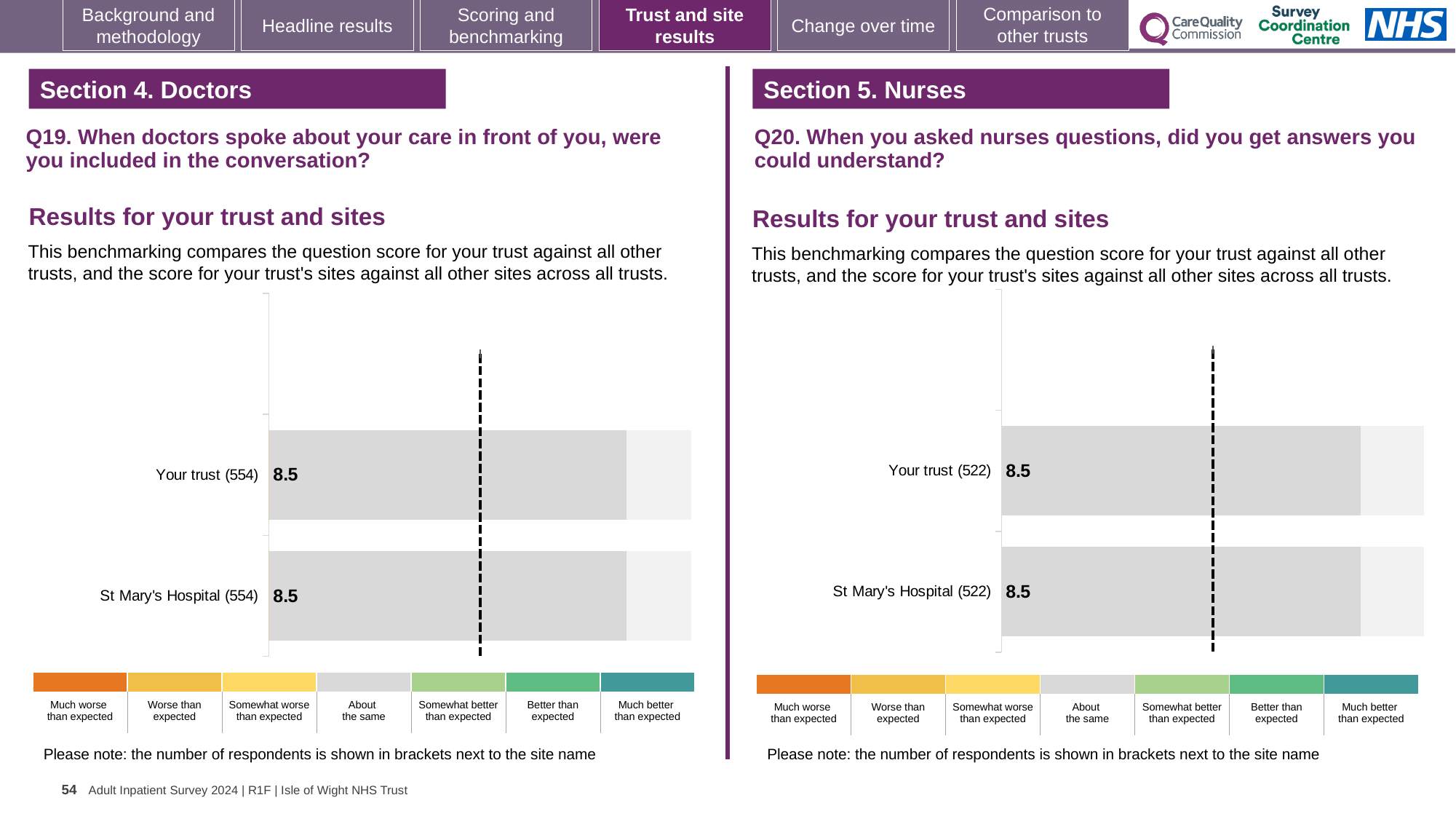
In the Q20 chart on the right, how many respondents are shown in brackets next to St Mary's Hospital? 522 In the Q20 chart on the right, what is the score for St Mary's Hospital? 8.5 In the Q19 chart on the left, what is the score for St Mary's Hospital? 8.5 In the Q19 chart on the left, how many respondents are shown in brackets next to Your trust? 554 How many bars are plotted in the Q19 chart on the left? 2 In the Q19 chart on the left, what is the difference between the score for Your trust and the score for St Mary's Hospital? 0 How many bars are plotted in the Q20 chart on the right? 2 In the Q20 chart on the right, what is the difference between the score for Your trust and the score for St Mary's Hospital? 0 In the Q19 chart on the left, what is the score for Your trust? 8.5 What kind of chart is the Q19 chart on the left? Bar chart In the Q20 chart on the right, what is the score for Your trust? 8.5